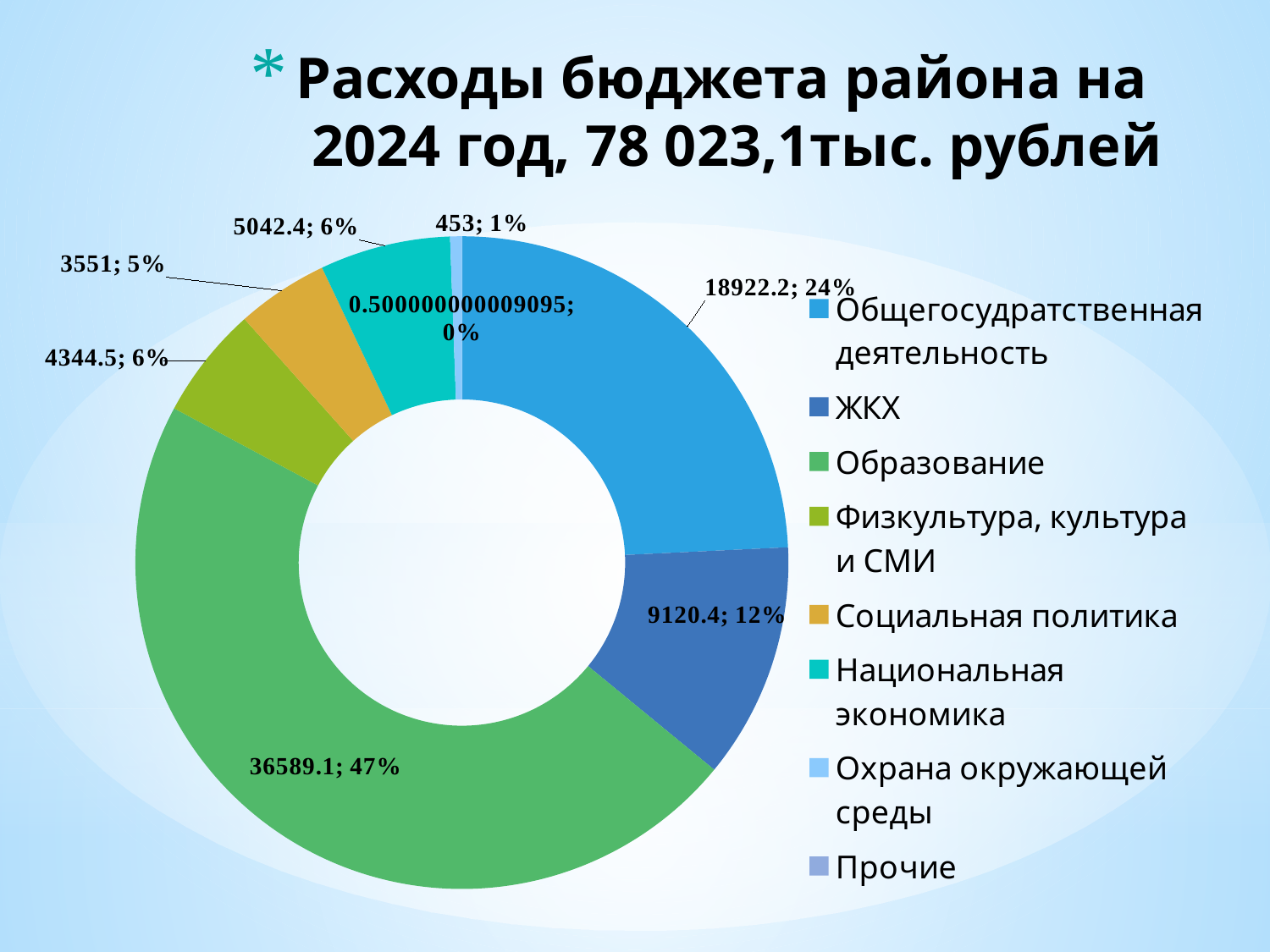
What is the difference between the values for Общегосударственная деятельность and ЖКХ? 9801.8 What value is shown for Образование? 36589.1 How many categories does the legend list? 8 What share of the budget does ЖКХ account for? 12% What value is shown for Физкультура, культура и СМИ? 4344.5 What kind of chart is shown on the slide? Doughnut chart Which is larger, the value for Национальная экономика or the value for Социальная политика? Национальная экономика Which category has the smallest share of the chart? Прочие Which category has the largest share of the chart? Образование What value is shown for Общегосударственная деятельность? 18922.2 What total amount is stated in the slide title? 78 023,1тыс. рублей What share of the chart does Охрана окружающей среды represent? 1%